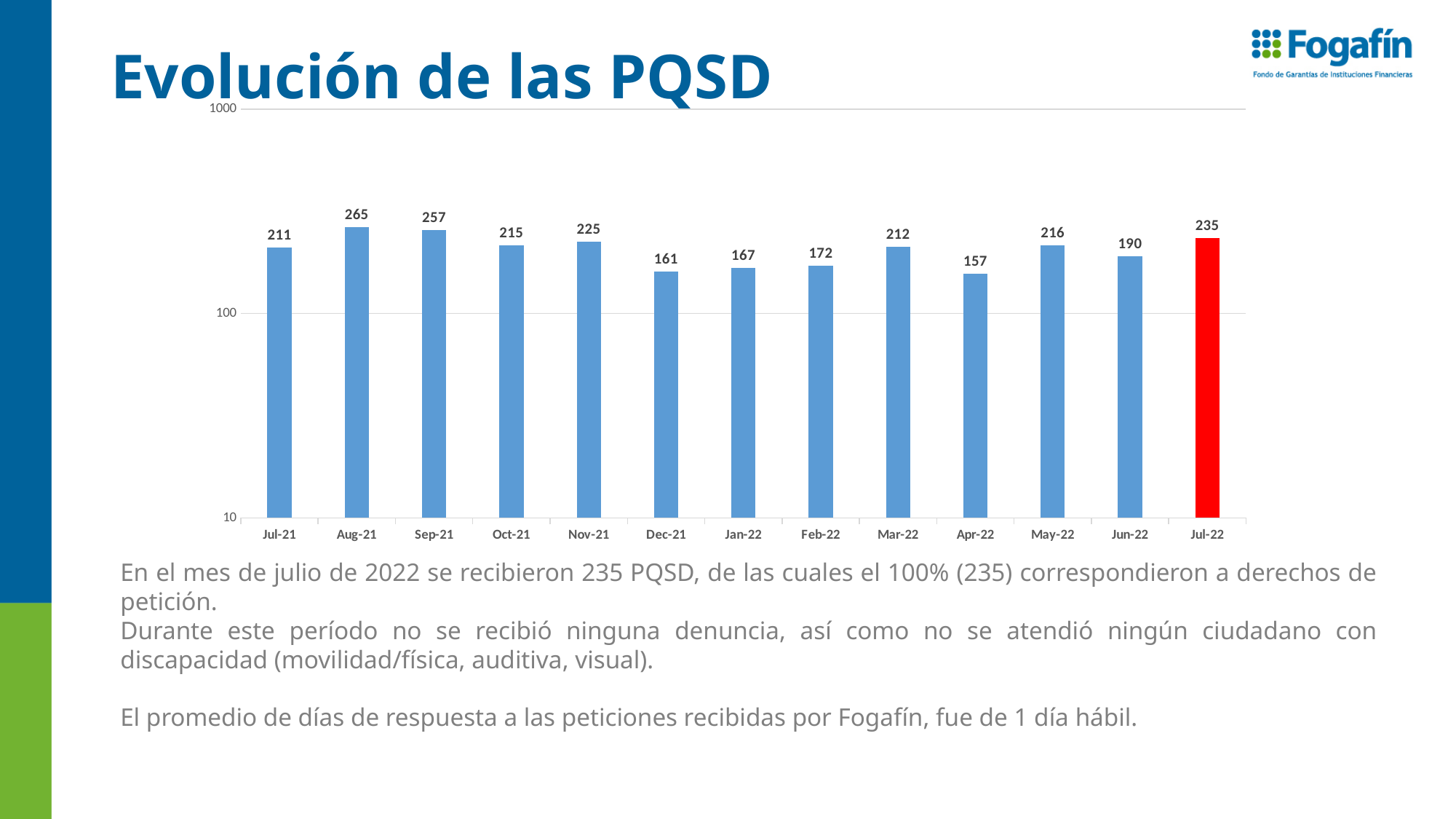
Which bar is coloured red instead of blue? Jul-22 What is the value for Apr-22? 157 What kind of chart is shown on the slide? bar chart What is the value for Jul-22? 235 Which month has the highest value? Aug-21 How many months are shown on the x axis? 13 Is the value for Dec-21 greater or less than 100? greater What is the difference between the values for Jun-22 and Jul-22? 45 Which month has the lowest value? Apr-22 Which is larger, the value for Nov-21 or the value for Oct-21? Nov-21 What is the value for Aug-21? 265 What is the difference between the values for Aug-21 and Jul-22? 30